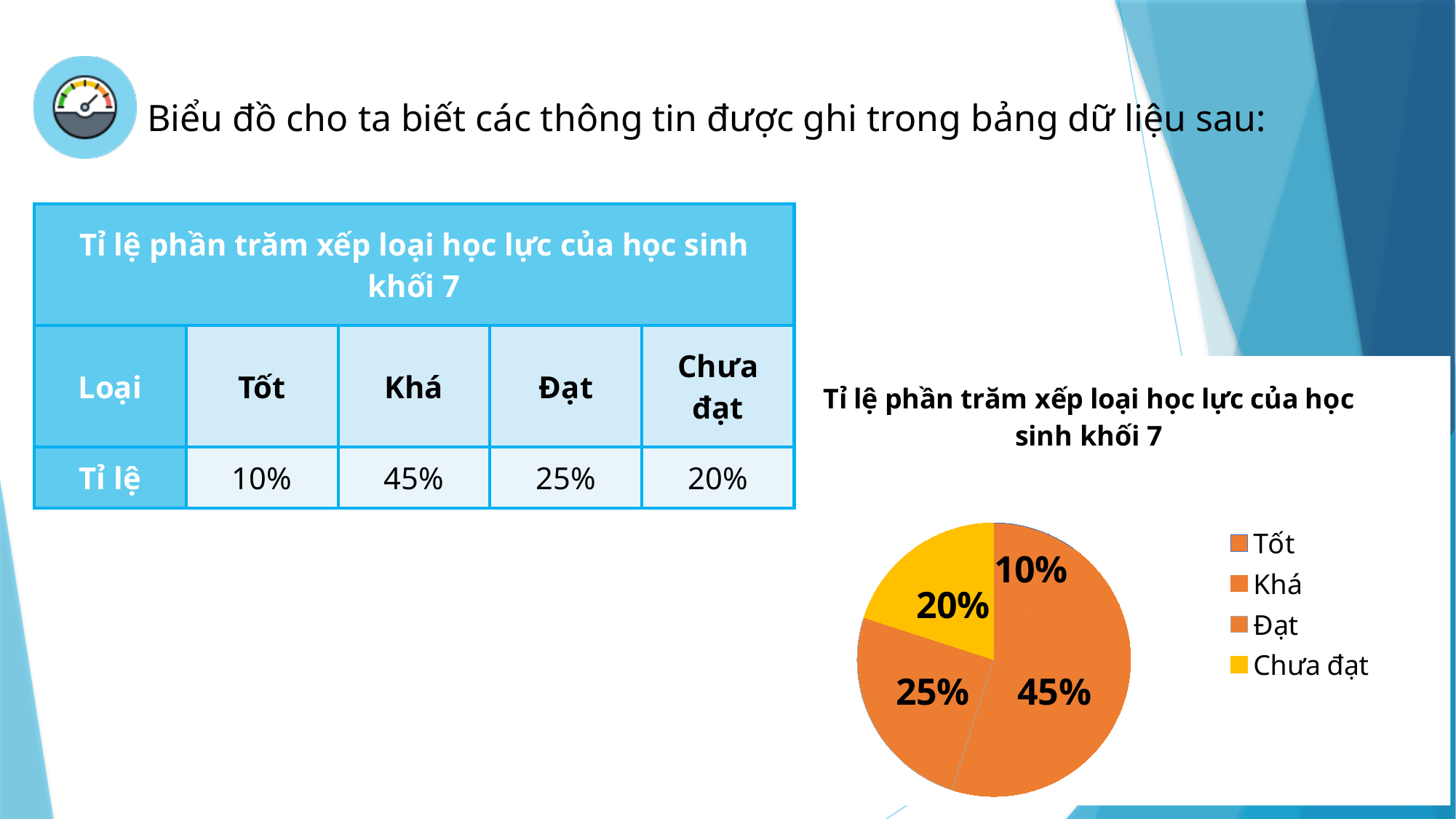
Which category has the largest slice in the pie chart? Khá How many entries does the legend of the pie chart list? 4 Which is larger in the pie chart, the share for Đạt or the share for Chưa đạt? Đạt What is the share of the pie chart for Khá? 45% What is the difference between the shares for Khá and Đạt in the pie chart? 20% Which category has the smallest slice in the pie chart? Tốt What is the title of the pie chart? Tỉ lệ phần trăm xếp loại học lực của học sinh khối 7 What is the share of the pie chart for Chưa đạt? 20% How many slices does the pie chart have? 4 What is the share of the pie chart for Tốt? 10% What kind of chart is shown on the slide? pie chart